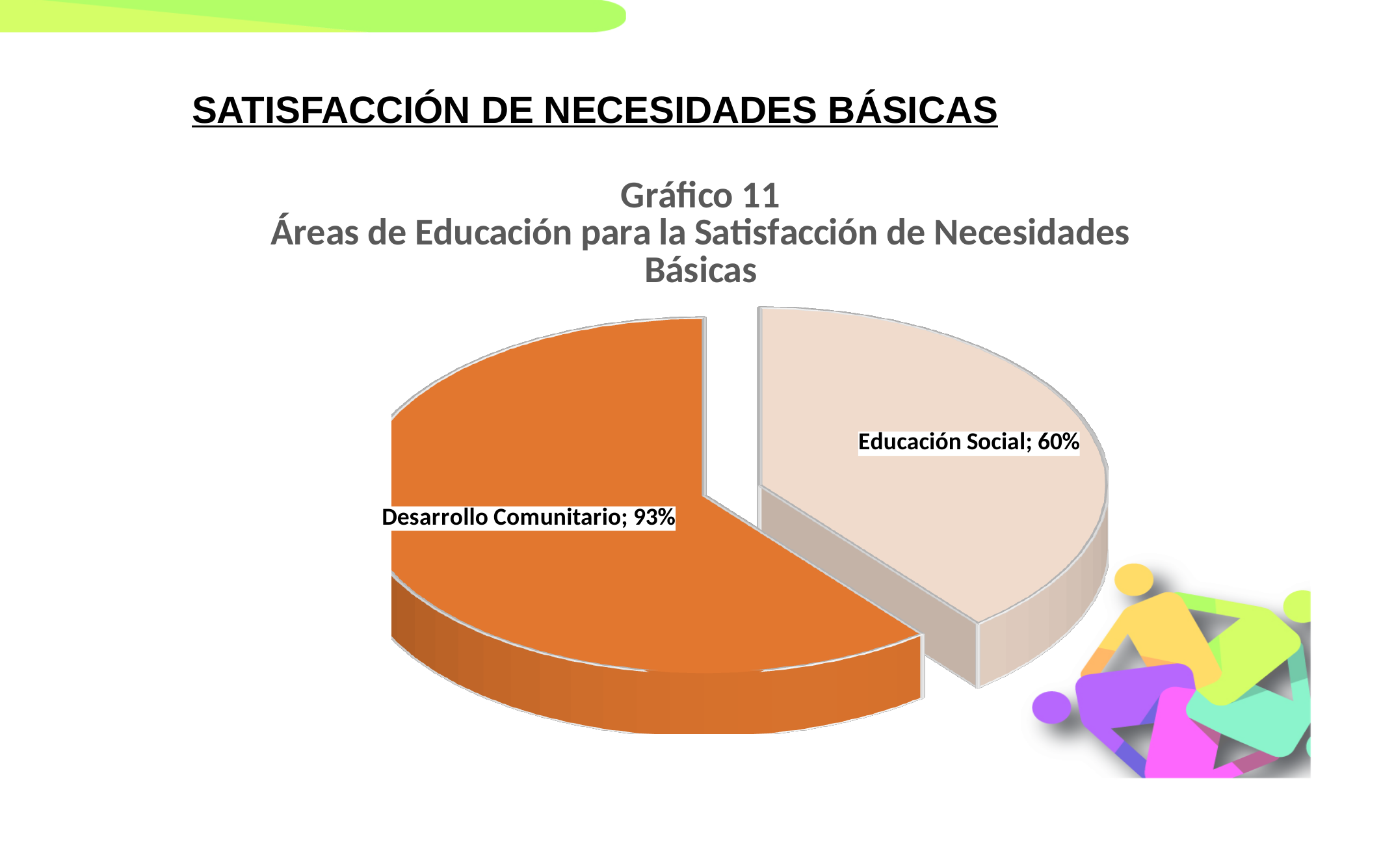
How many slices does the pie chart have? 2 What value is shown for Educación Social? 60% What is the title of the chart? Gráfico 11 Áreas de Educación para la Satisfacción de Necesidades Básicas Which is larger, Desarrollo Comunitario or Educación Social? Desarrollo Comunitario Which category has the lowest value? Educación Social What type of chart is shown on the slide? pie chart What colour is the Desarrollo Comunitario slice? orange Which category has the highest value? Desarrollo Comunitario What value is shown for Desarrollo Comunitario? 93% What is the difference between the values for Desarrollo Comunitario and Educación Social? 33 percentage points